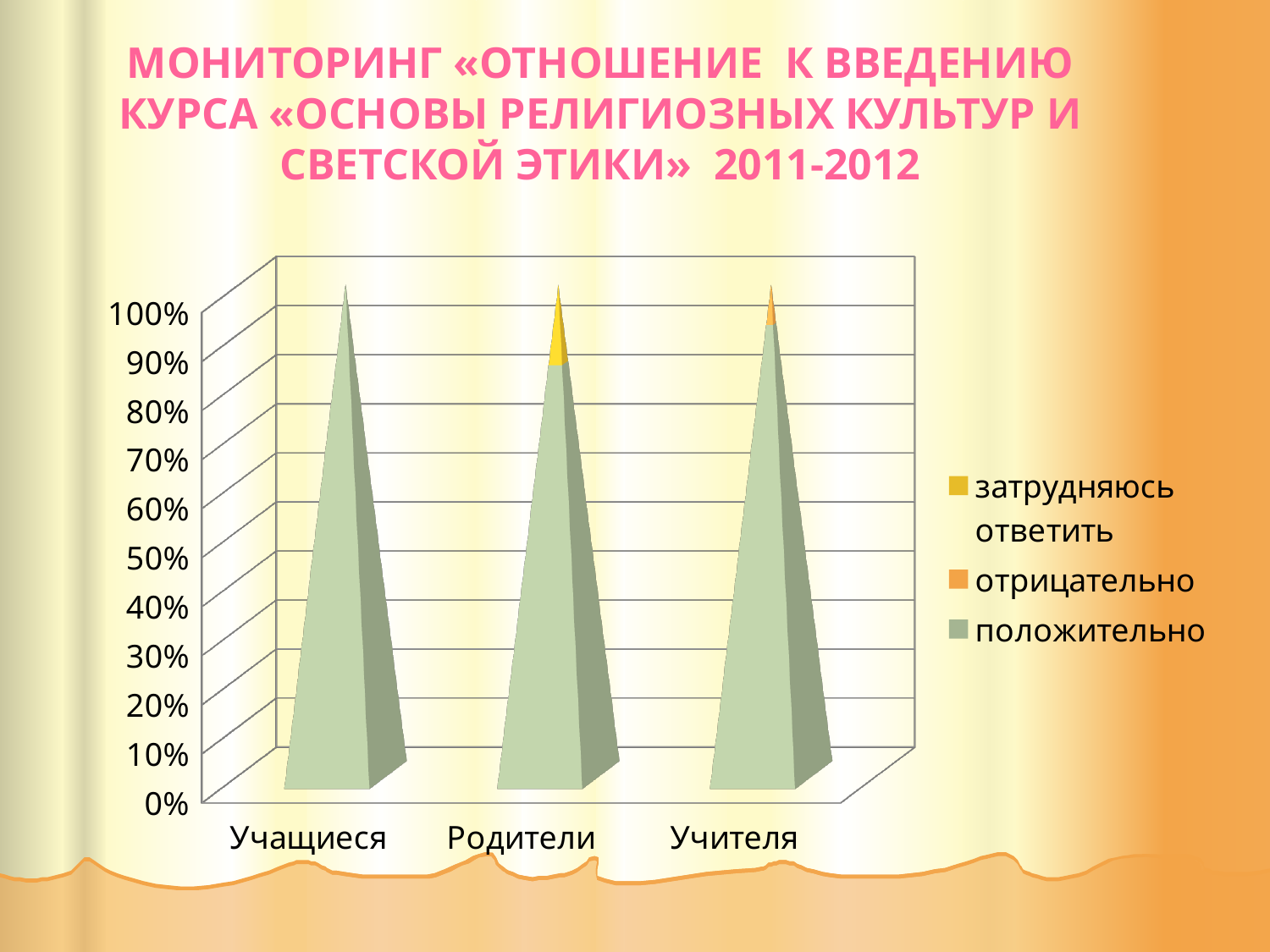
Which category is listed first on the x axis of the chart? Учащиеся Which series in the legend is shown in green? положительно What kind of chart is shown on the slide? bar chart Which category has the highest value for положительно? Учащиеся Is the value for положительно for Учителя greater or less than 90%? greater How many series does the chart legend list? 3 Is the value for затрудняюсь ответить for Родители greater or less than 20%? less Is the value for положительно for Родители greater or less than 80%? greater Which category has the lowest value for положительно? Родители How many categories are shown on the x axis of the chart? 3 Which is larger: положительно for Учащиеся or положительно for Родители? Учащиеся